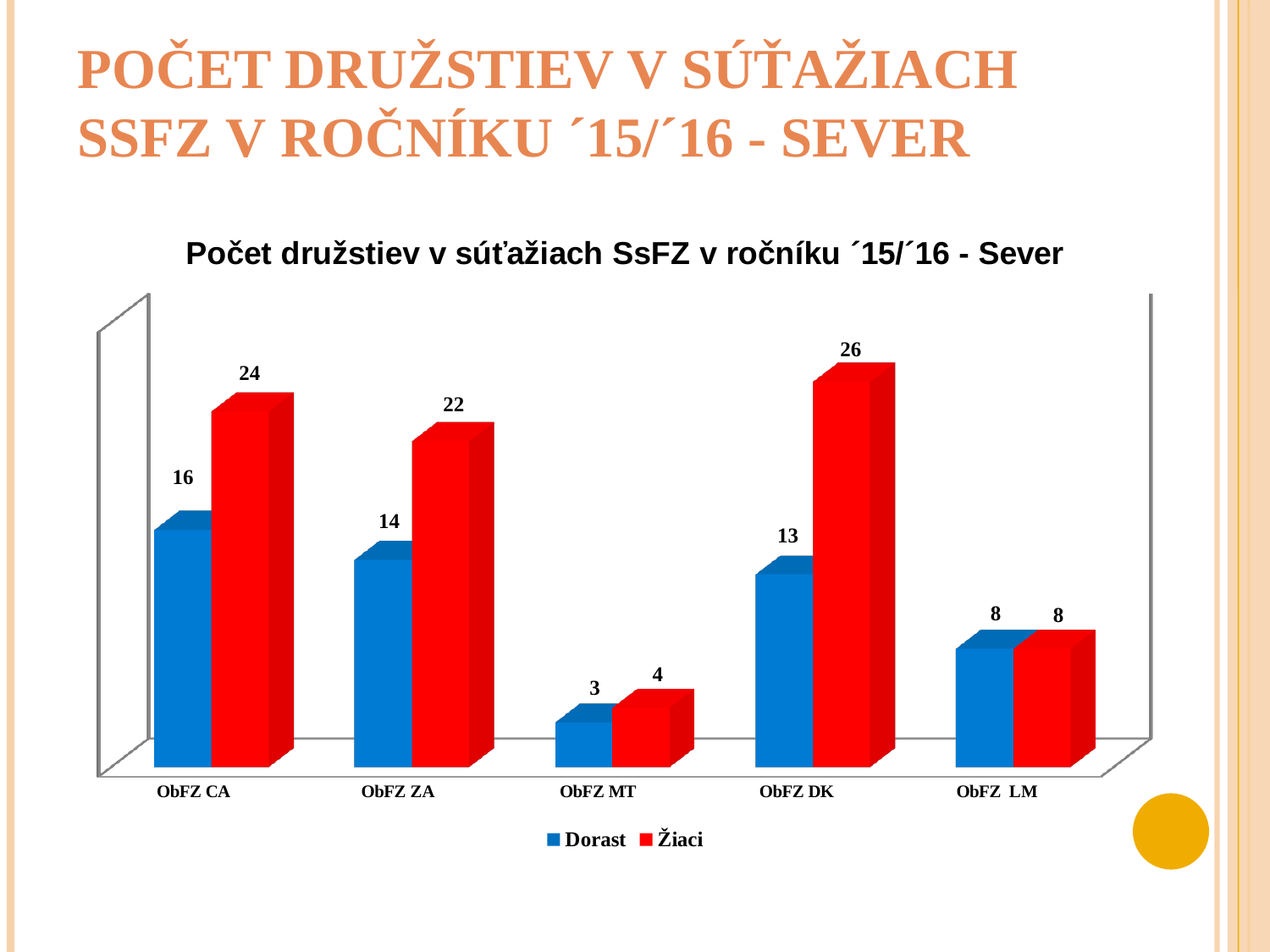
What is the Žiaci value for ObFZ MT? 4 Which category has the highest Žiaci value? ObFZ DK What is the Žiaci value for ObFZ DK? 26 Which is larger, the Dorast value for ObFZ CA or the Dorast value for ObFZ DK? ObFZ CA Which category has the lowest Dorast value? ObFZ MT What is the difference between the Žiaci and Dorast values for ObFZ ZA? 8 What kind of chart is shown? bar chart What is the Dorast value for ObFZ CA? 16 How many categories are shown on the x axis? 5 Which colour represents the Dorast series? blue What is the difference between the Žiaci values for ObFZ DK and ObFZ CA? 2 How many series does the legend list? 2